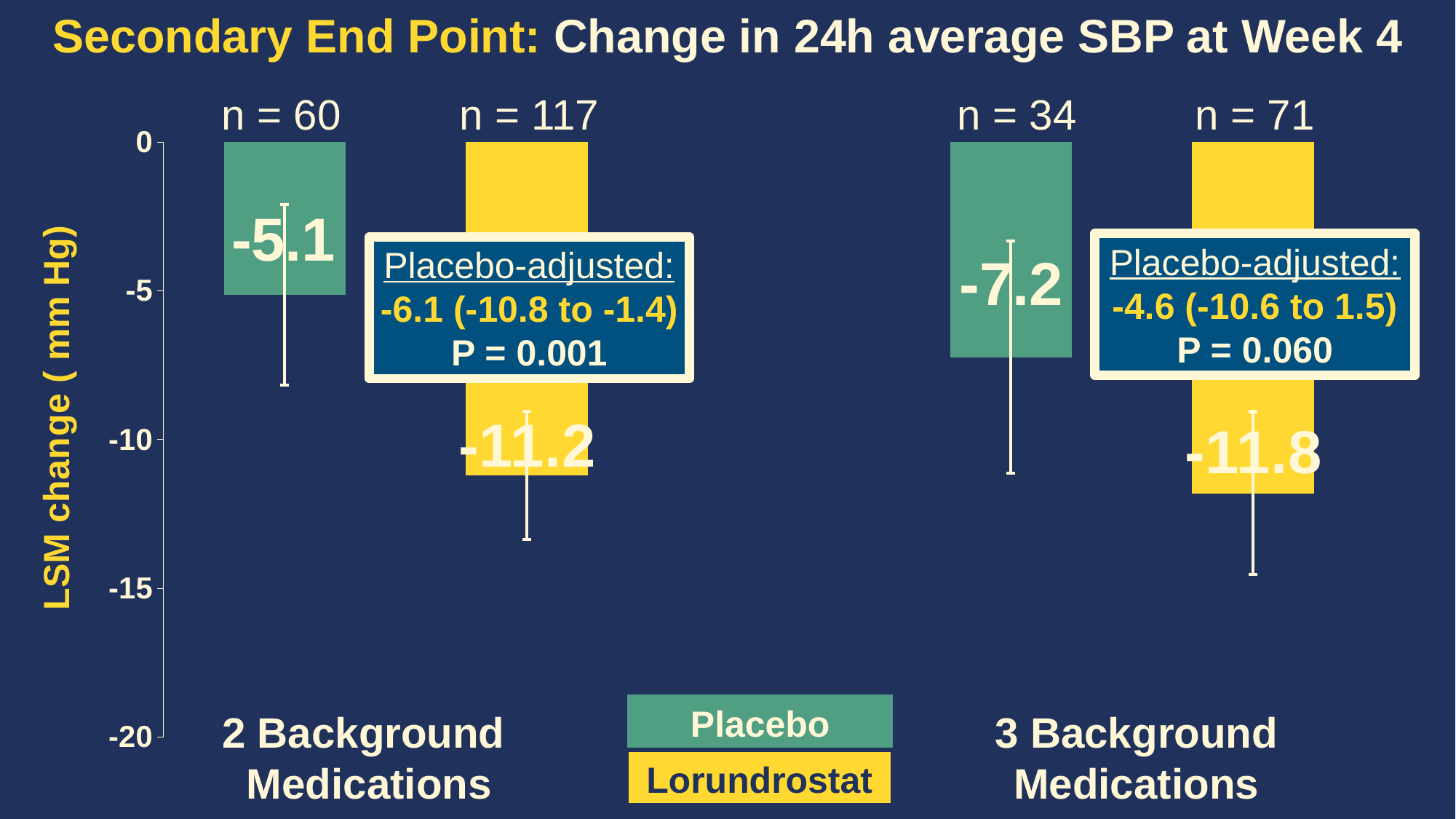
How many patients (n) were in the Lorundrostat arm of the 2 Background Medications group? n = 117 What is the P value for the placebo-adjusted change in the 3 Background Medications group? P = 0.060 What is the placebo-adjusted change in 24h average SBP for the 2 Background Medications group? -6.1 (-10.8 to -1.4) Which bar shows the smallest reduction (least negative LSM change) in 24h average SBP? Placebo, 2 Background Medications Is the LSM change for Lorundrostat in the 3 Background Medications group greater or less than -10? less What is the LSM change for Lorundrostat in the 2 Background Medications group? -11.2 How many series does the legend list? 2 What is the LSM change in 24h average SBP for Placebo in the 2 Background Medications group? -5.1 What is the LSM change in 24h average SBP for Lorundrostat in the 3 Background Medications group? -11.8 What type of chart is shown on the slide? Bar chart What is the LSM change for Placebo in the 3 Background Medications group? -7.2 Which bar shows the largest reduction (most negative LSM change) in 24h average SBP? Lorundrostat, 3 Background Medications